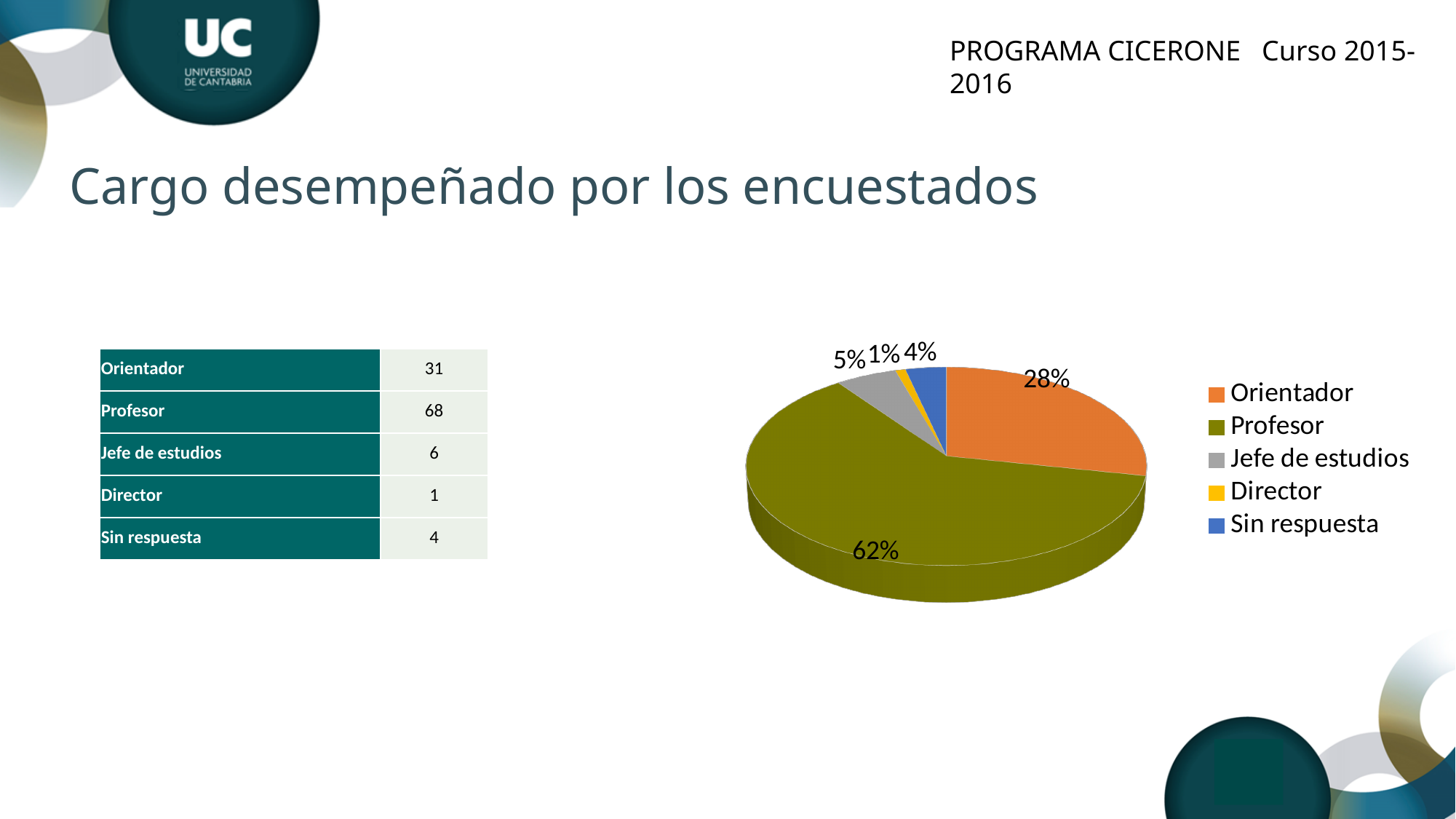
What share of the pie does Profesor represent? 62% How many categories does the pie chart show? 5 What kind of chart is shown on the slide? pie chart Which category has the largest slice of the pie? Profesor What share of the pie does Director represent? 1% What is the difference in percentage points between the Profesor and Orientador slices? 34 What share of the pie does Jefe de estudios represent? 5% What colour is the Orientador slice in the pie chart? orange Which category has the smallest slice of the pie? Director Which slice is larger, Jefe de estudios or Sin respuesta? Jefe de estudios